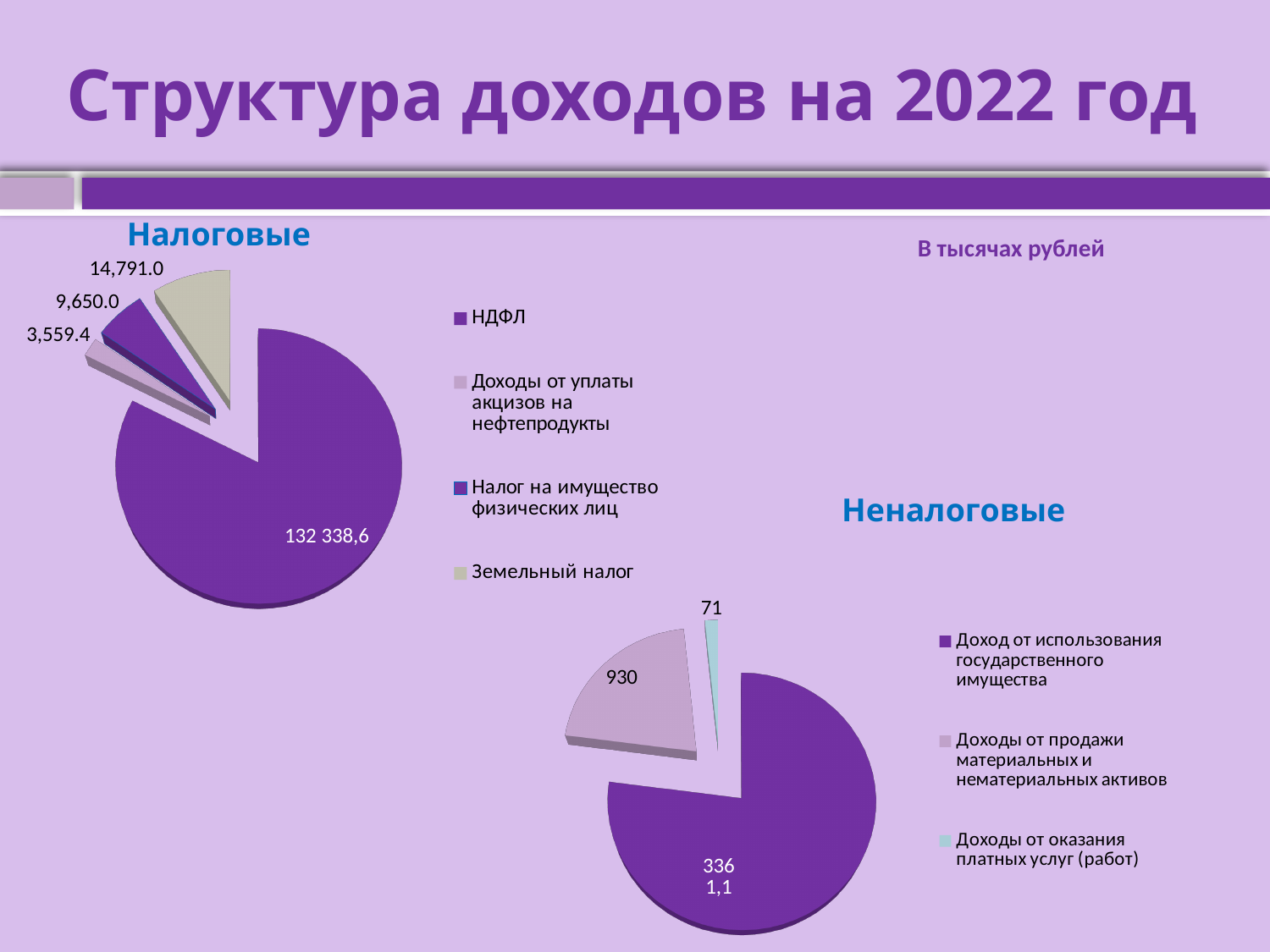
In the 'Налоговые' chart, what is the difference between Земельный налог and Налог на имущество физических лиц? 5,141.0 What kind of chart is the 'Налоговые' chart? pie chart In the 'Неналоговые' chart, what is the value for Доходы от продажи материальных и нематериальных активов? 930 In what units are the values on the slide given? В тысячах рублей In the 'Налоговые' chart, what is the value for Земельный налог? 14,791.0 In the 'Неналоговые' chart, what is the value for Доходы от оказания платных услуг (работ)? 71 In the 'Неналоговые' chart, which category has the largest slice? Доход от использования государственного имущества In the 'Налоговые' chart, what is the value for НДФЛ? 132 338,6 In the 'Налоговые' chart, which category has the smallest slice? Доходы от уплаты акцизов на нефтепродукты In the 'Налоговые' chart, what is the value for Доходы от уплаты акцизов на нефтепродукты? 3,559.4 In the 'Налоговые' chart, what is the value for Налог на имущество физических лиц? 9,650.0 How many categories does the 'Налоговые' chart show? 4